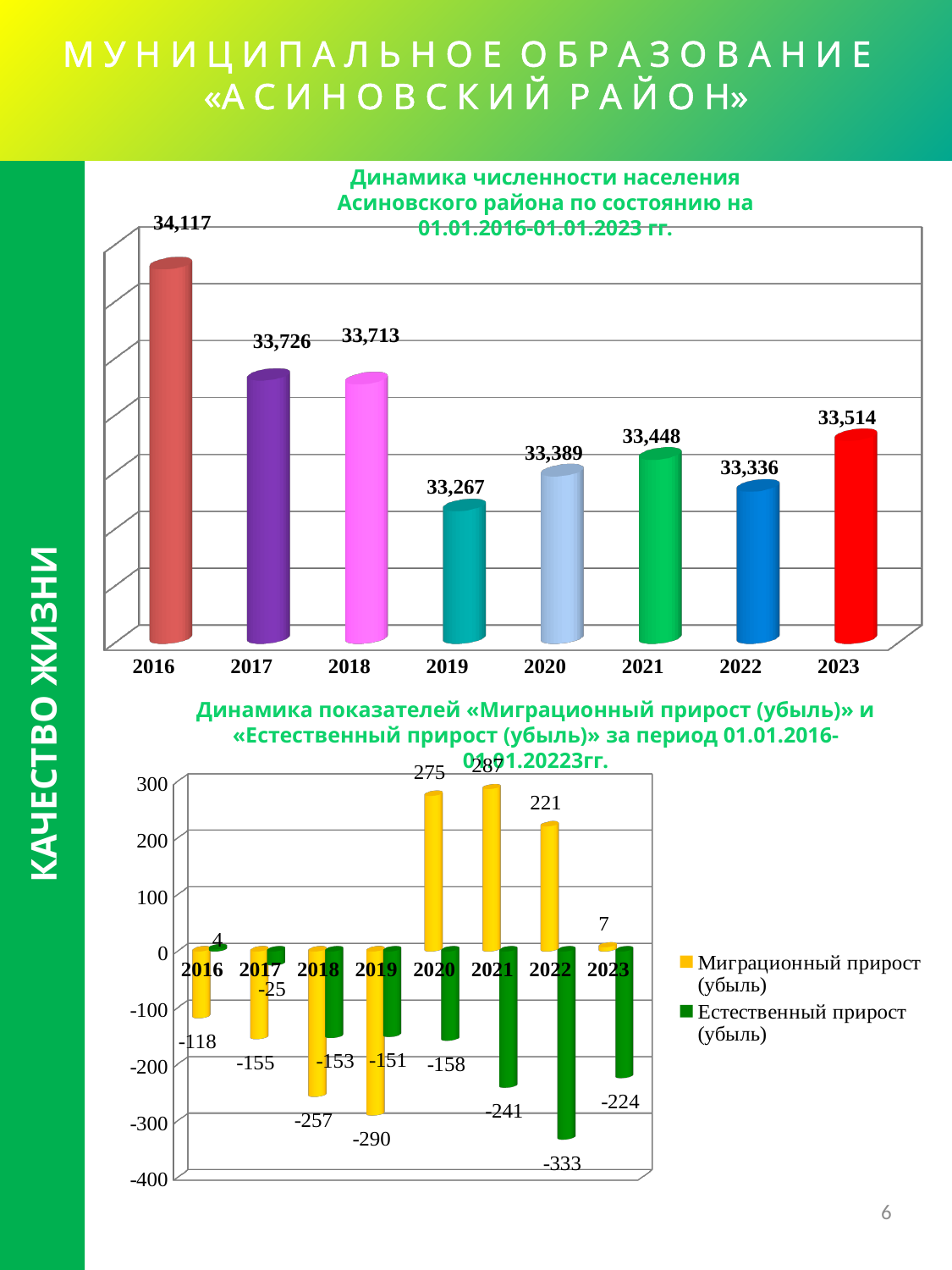
In the top chart (Динамика численности населения), how many years are shown on the x axis? 8 What type of chart is the top chart (Динамика численности населения)? Bar chart In the bottom chart (Динамика показателей), what is the value of Миграционный прирост (убыль) for 2019? -290 In the top chart (Динамика численности населения), what is the difference between the 2016 and 2023 values? 603 In the bottom chart (Динамика показателей), what is the value of Естественный прирост (убыль) for 2022? -333 In the top chart (Динамика численности населения), what is the population value for 2023? 33,514 In the top chart (Динамика численности населения), what is the population value for 2016? 34,117 In the bottom chart (Динамика показателей), how many series does the legend list? 2 In the bottom chart (Динамика показателей), which year has the highest Миграционный прирост (убыль) value? 2021 In the top chart (Динамика численности населения), which year has the highest population? 2016 In the bottom chart (Динамика показателей), is the Миграционный прирост (убыль) value for 2020 larger than the Естественный прирост (убыль) value for 2020? Yes In the top chart (Динамика численности населения), which year has the lowest population? 2019